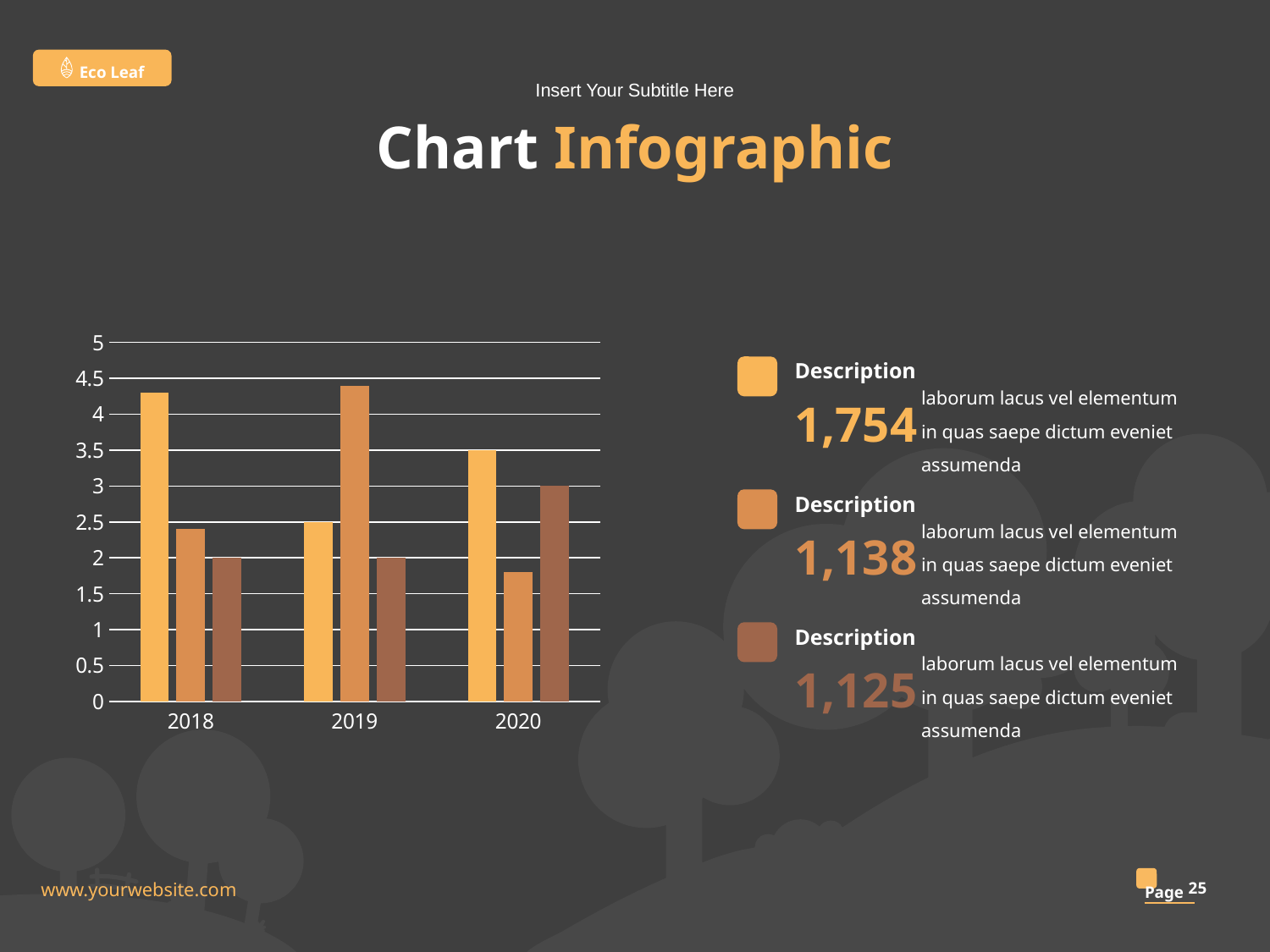
Is the value of the medium orange bar for 2020 greater or less than 2? less In which year is the light orange bar the tallest? 2018 For 2018, which is larger: the medium orange bar or the brown bar? the medium orange bar What kind of chart is shown on the slide? bar chart For 2020, which is larger: the light orange bar or the brown bar? the light orange bar In which year is the medium orange bar the shortest? 2020 Is the value of the light orange bar for 2018 greater or less than 4? greater How many bars are plotted for each year in the chart? 3 How many years are shown on the x axis of the chart? 3 Does the brown bar rise or fall from 2019 to 2020? rise What is the highest value shown on the chart's vertical axis? 5 Is the value of the medium orange bar for 2019 greater or less than 4? greater